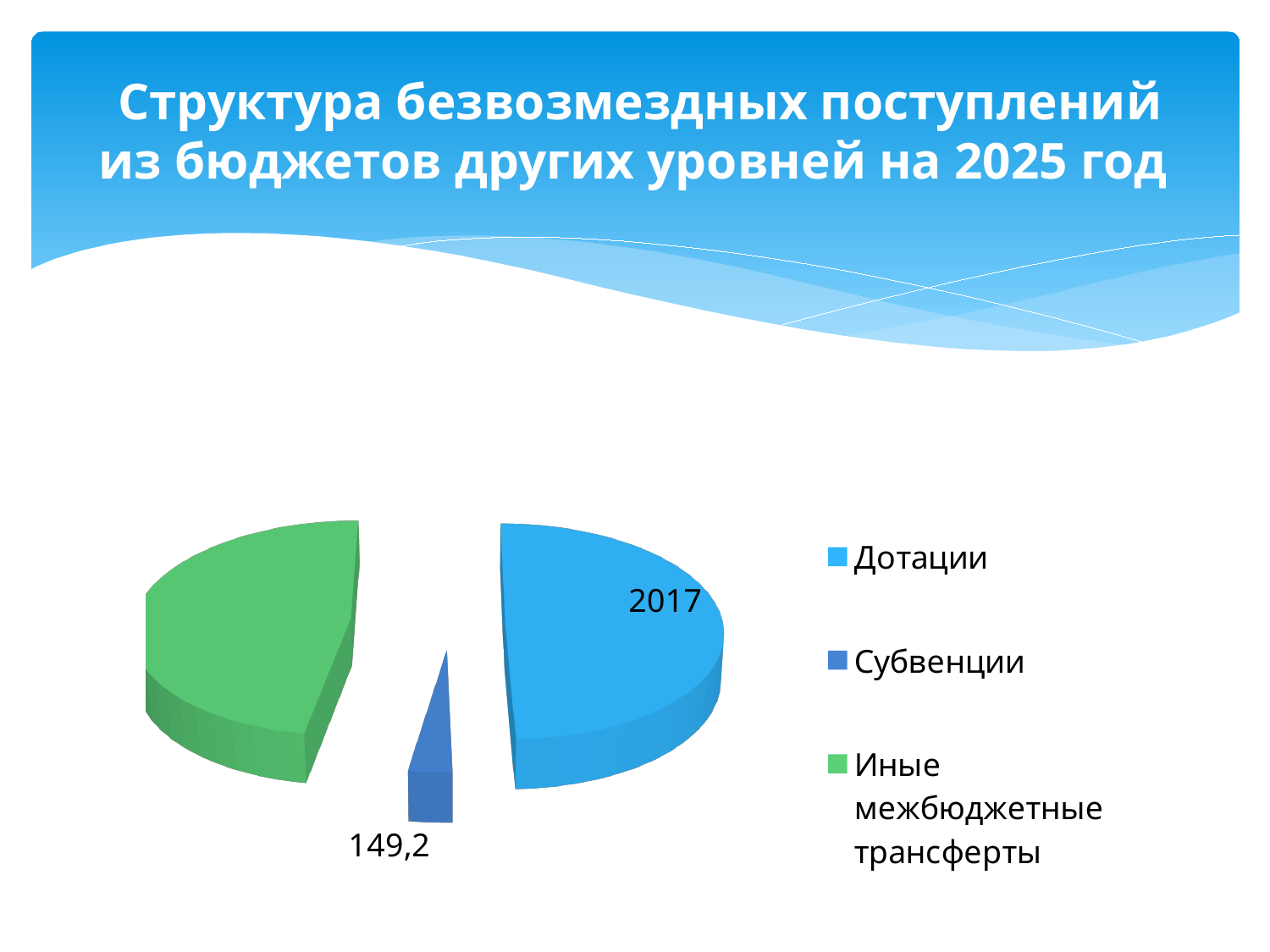
What colour is the Дотации slice? Blue Which is larger, the Дотации slice or the Субвенции slice? Дотации What is the value shown for the Дотации slice? 2017 Which category has the smallest slice of the pie? Субвенции How many entries does the legend list? 3 Which is larger, the Иные межбюджетные трансферты slice or the Субвенции slice? Иные межбюджетные трансферты How many slices does the pie chart have? 3 What is the value shown for the Субвенции slice? 149,2 What is the difference between the Дотации value and the Субвенции value? 1867,8 What is the title of the slide? Структура безвозмездных поступлений из бюджетов других уровней на 2025 год What kind of chart is shown on the slide? Pie chart